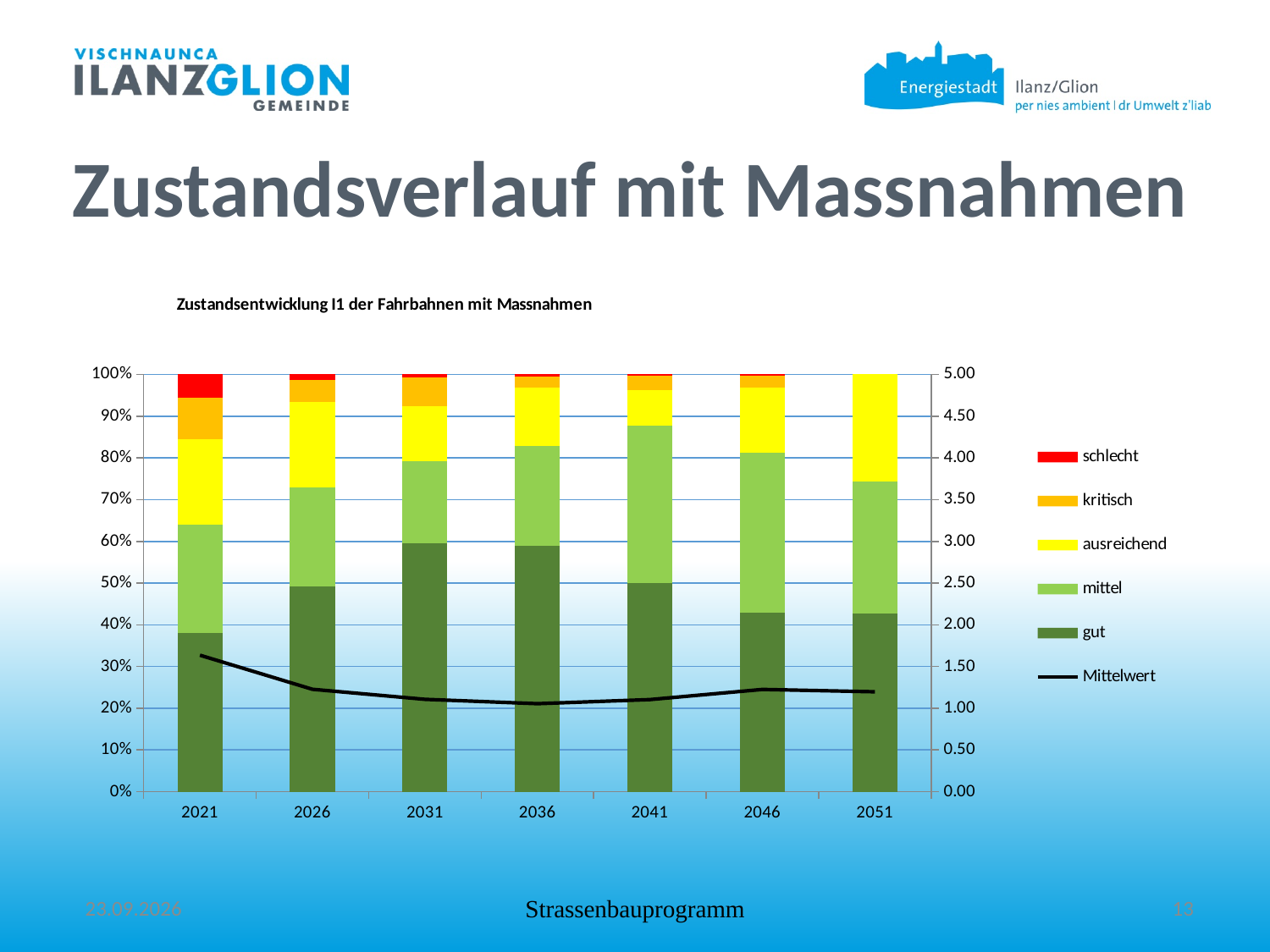
In which year is the 'gut' segment smallest? 2021 Is the share of 'gut' in 2031 greater or less than 50%? greater How many years are shown on the x axis? 7 Is the Mittelwert value for 2021 greater or less than 1.50 on the right axis? greater Is the Mittelwert value for 2036 greater or less than 1.50 on the right axis? less Does the Mittelwert line rise or fall from 2021 to 2036? fall In which year is the 'schlecht' segment largest? 2021 What kind of chart is shown on the slide? stacked bar chart with a line What is the title of the chart? Zustandsentwicklung I1 der Fahrbahnen mit Massnahmen How many series does the legend list? 6 Which series is plotted as a line rather than as bars? Mittelwert